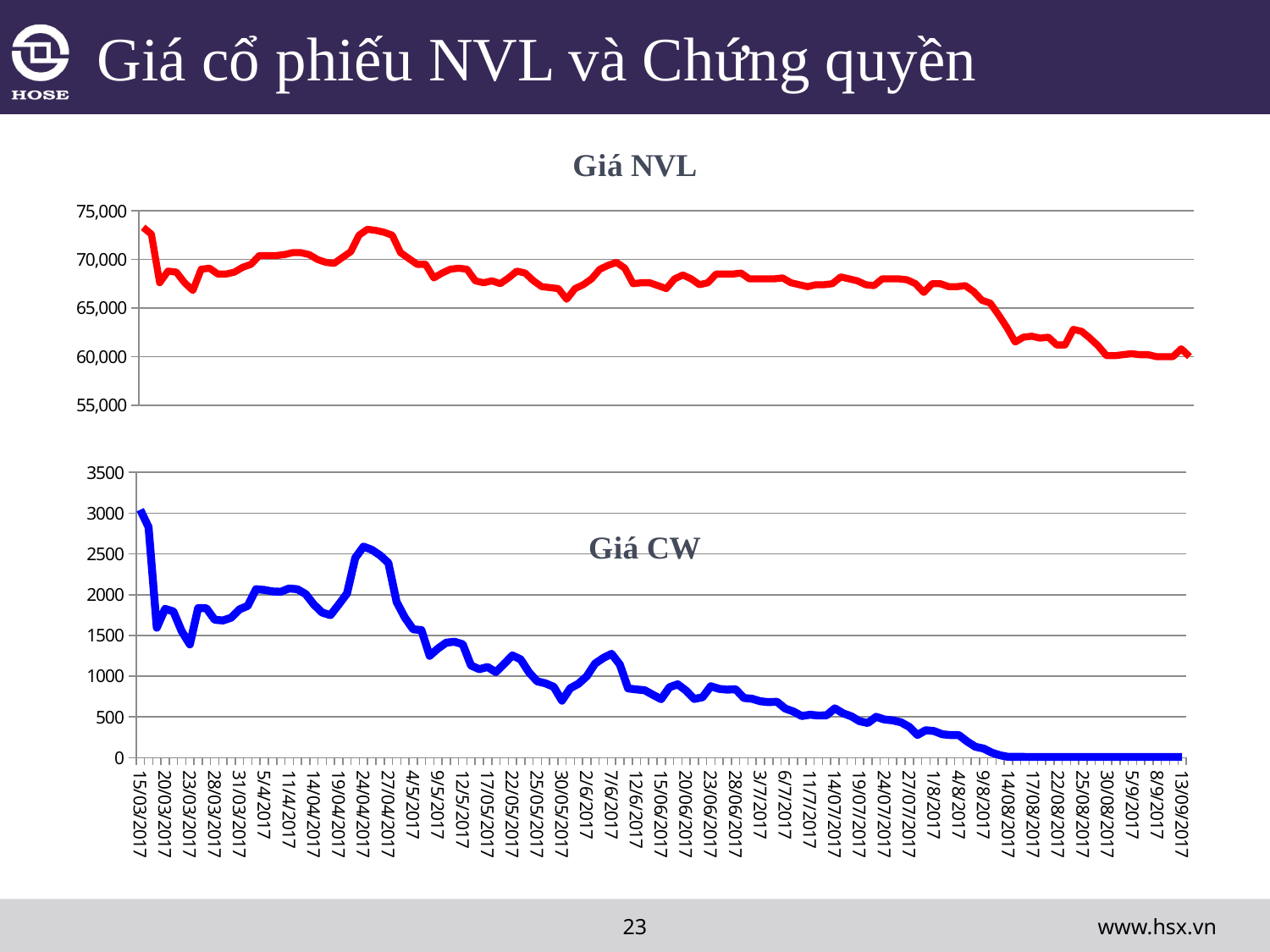
In the 'Giá CW' chart, which is larger: the value on 24/04/2017 or the value on 13/09/2017? 24/04/2017 In the 'Giá NVL' chart, is the value on 15/03/2017 greater or less than 70,000? greater In the 'Giá CW' chart, is the value on 15/03/2017 greater or less than 2500? greater What colour is the line in the 'Giá CW' chart? blue In the 'Giá NVL' chart, is the value on 13/09/2017 greater or less than 65,000? less In the 'Giá CW' chart, do the values overall rise or fall from 15/03/2017 to 13/09/2017? fall In the 'Giá NVL' chart, do the values overall rise or fall from 15/03/2017 to 13/09/2017? fall What kind of chart is the 'Giá CW' chart? line chart What kind of chart is the 'Giá NVL' chart? line chart How many data series are plotted in the 'Giá NVL' chart? 1 In the 'Giá CW' chart, on which date is the value highest? 15/03/2017